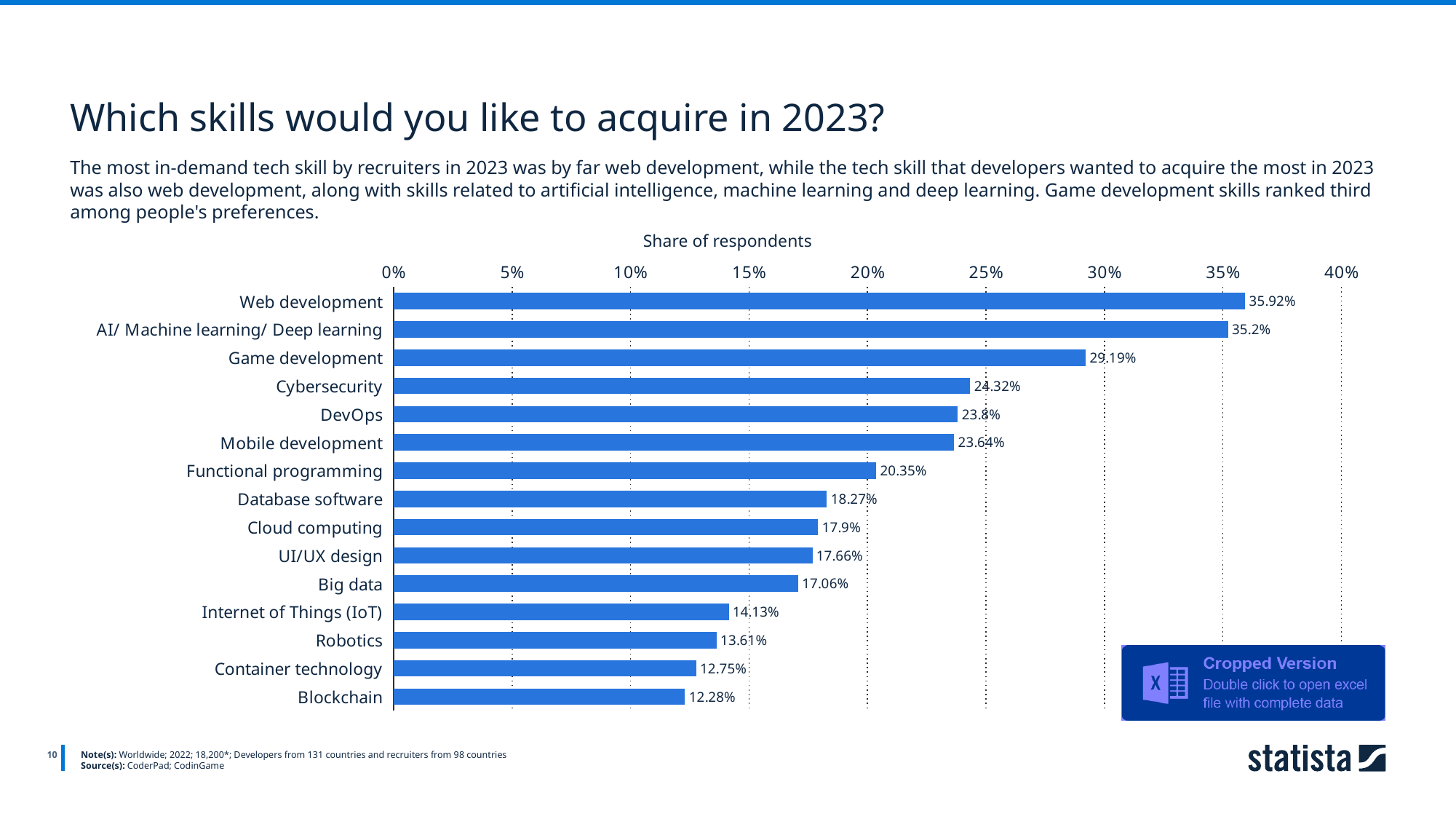
What is the value shown for Cybersecurity? 24.32% Is the value for Internet of Things (IoT) greater or less than 15%? less What share of respondents wanted to acquire Game development skills? 29.19% What is the difference between the shares for Cloud computing and Big data? 0.84% What share of respondents is shown for Blockchain? 12.28% Which skill has the highest share of respondents? Web development How many skills are listed in the chart? 15 Which has a larger share of respondents, Functional programming or Database software? Functional programming What is the label of the chart's value axis? Share of respondents What kind of chart is shown on the slide? Bar chart What is the difference between the shares for Web development and Game development? 6.73% Which skill has the lowest share of respondents? Blockchain